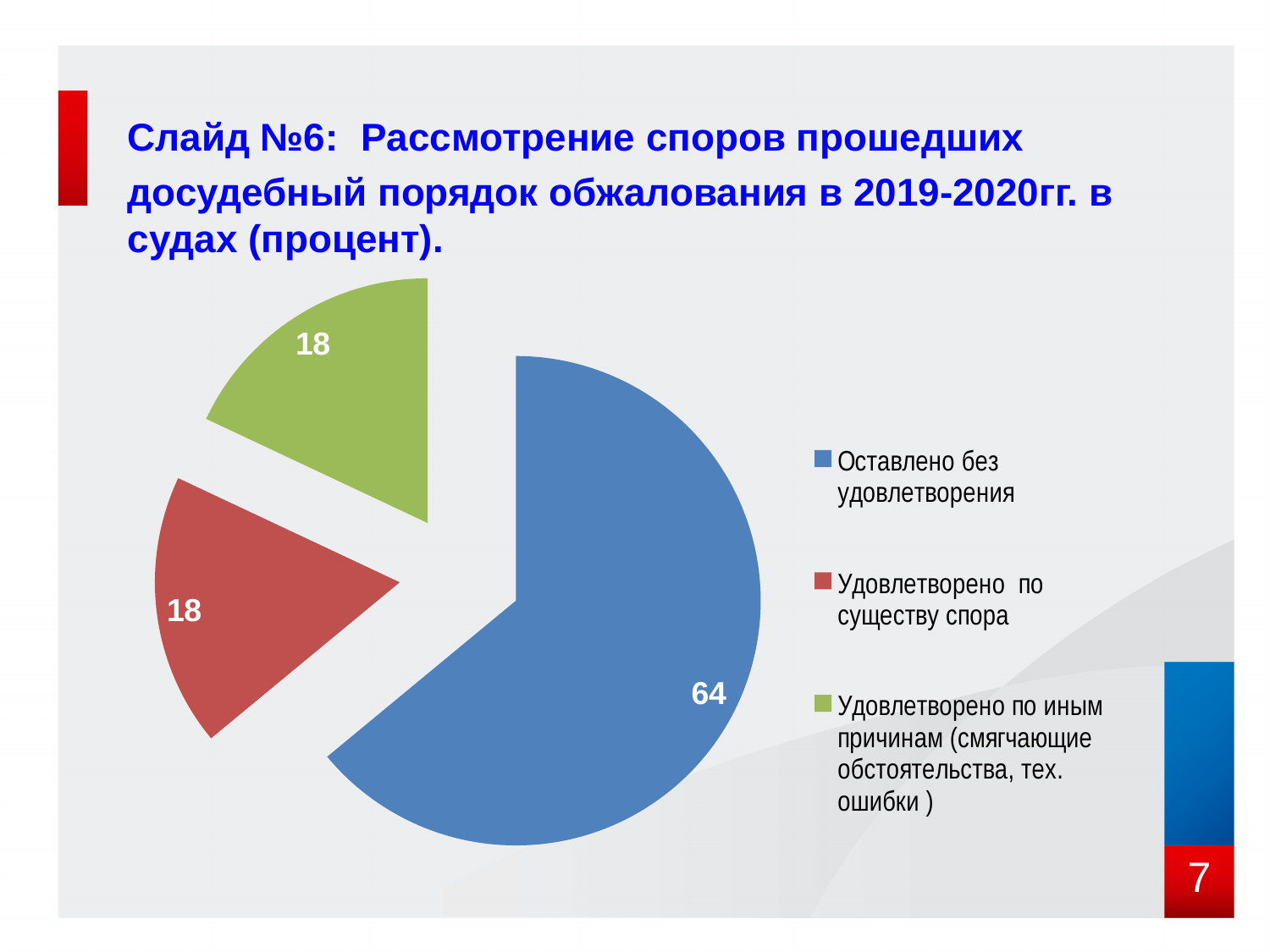
What share of the pie does "Оставлено без удовлетворения" represent? 64% How many entries does the legend list? 3 What is the difference between the value for "Оставлено без удовлетворения" and the value for "Удовлетворено по существу спора"? 46 Which is larger: the value for "Оставлено без удовлетворения" or the value for "Удовлетворено по иным причинам"? Оставлено без удовлетворения What is the total of all the slice values shown on the pie chart? 100 What is the value for "Оставлено без удовлетворения"? 64 What colour is the slice for "Удовлетворено по существу спора"? red How many slices does the pie chart have? 3 What is the value for "Удовлетворено по существу спора"? 18 Which category has the largest slice of the pie? Оставлено без удовлетворения What type of chart is shown on the slide? pie chart What is the value for "Удовлетворено по иным причинам (смягчающие обстоятельства, тех. ошибки)"? 18